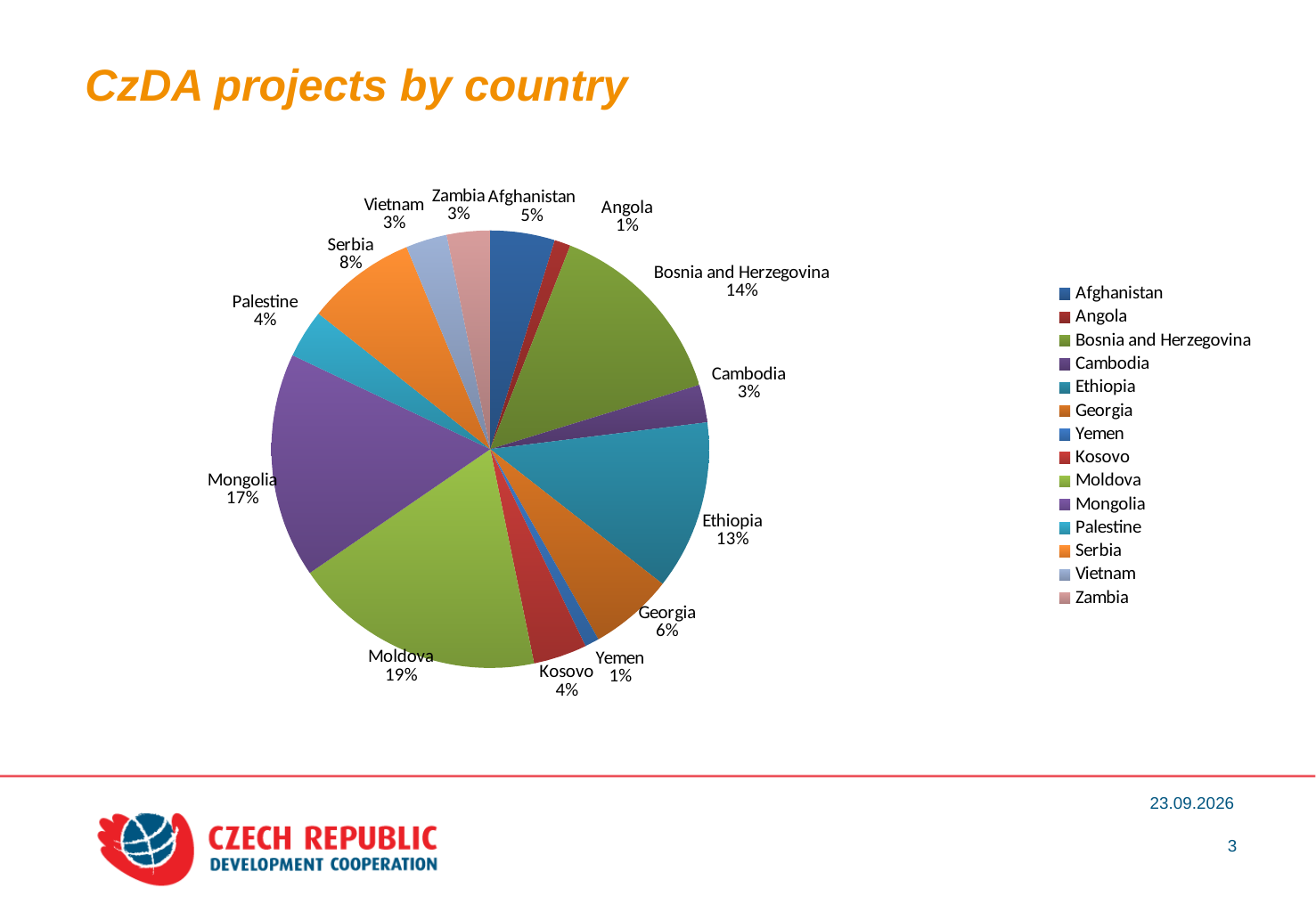
Which has a larger share, Georgia or Palestine? Georgia Which has a larger share, Ethiopia or Bosnia and Herzegovina? Bosnia and Herzegovina What type of chart is shown on the slide? Pie chart What is the title of the slide? CzDA projects by country What percentage of the pie does Ethiopia account for? 13% Which country has the largest slice of the pie? Moldova What is the difference in percentage points between Mongolia and Bosnia and Herzegovina? 3 How many entries does the legend list? 14 How many countries are shown in the pie chart? 14 What share of CzDA projects is in Moldova? 19% What is the value shown for Serbia? 8% What is the combined share of Vietnam and Zambia? 6%